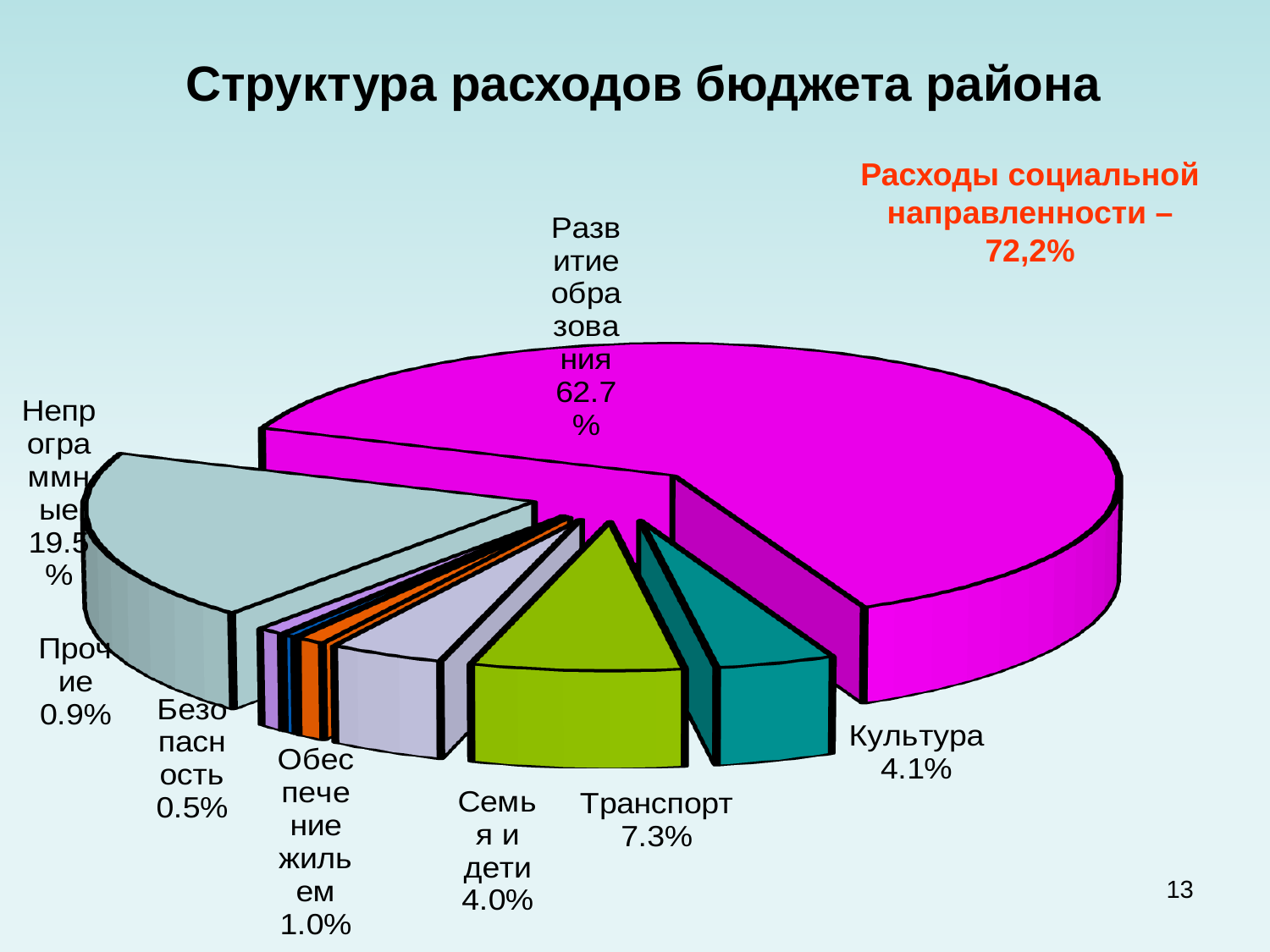
What is the value for Транспорт? 7.3% What share of the budget expenditures goes to Развитие образования? 62.7% Which category has the largest share of the pie? Развитие образования What is the difference between the shares of Транспорт and Культура? 3.2% Which is larger, the share for Прочие or the share for Безопасность? Прочие Which labeled category has the smallest share of the pie? Безопасность What is the value for Семья и дети? 4.0% What is the value for Обеспечение жильем? 1.0% What is the value for Культура? 4.1% What is the value for Непрограммные? 19.5% What is the title of the chart? Структура расходов бюджета района What type of chart is shown on the slide? pie chart